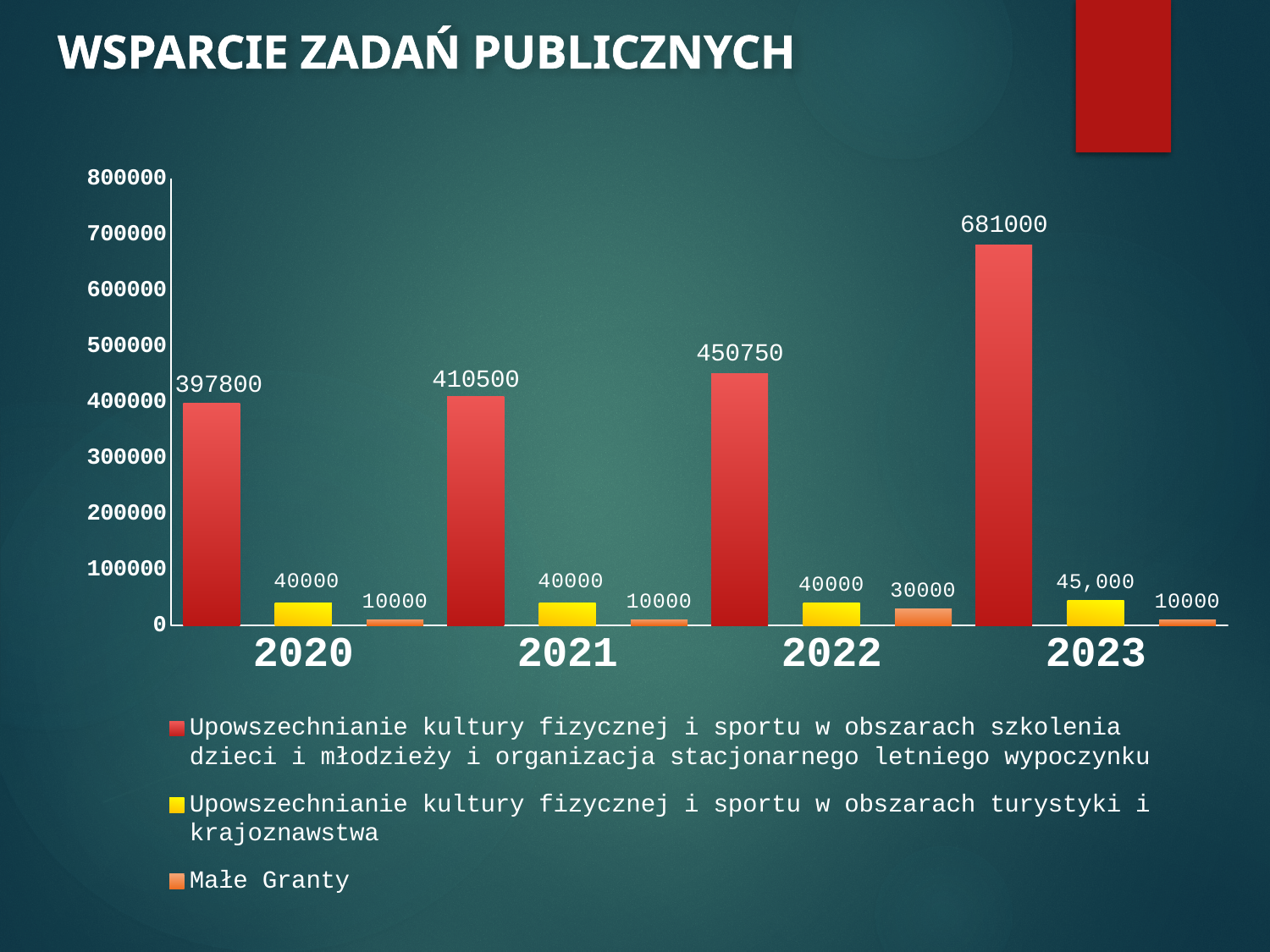
What is the value for the yellow series (turystyki i krajoznawstwa) in 2023? 45,000 Does the red series rise or fall from 2020 to 2023? rise What kind of chart is shown on the slide? bar chart What is the value for the red series (Upowszechnianie kultury fizycznej i sportu w obszarach szkolenia dzieci i młodzieży...) in 2023? 681000 In which year is the red series (szkolenia dzieci i młodzieży) lowest? 2020 What is the difference between the red series values for 2023 and 2022? 230250 Which is larger: the red series value in 2021 or in 2020? 2021 How many years are shown on the x axis? 4 In which year is the red series (szkolenia dzieci i młodzieży) highest? 2023 Is the red series value for 2022 greater or less than 400000? greater How many series does the legend list? 3 What is the value for Małe Granty in 2022? 30000